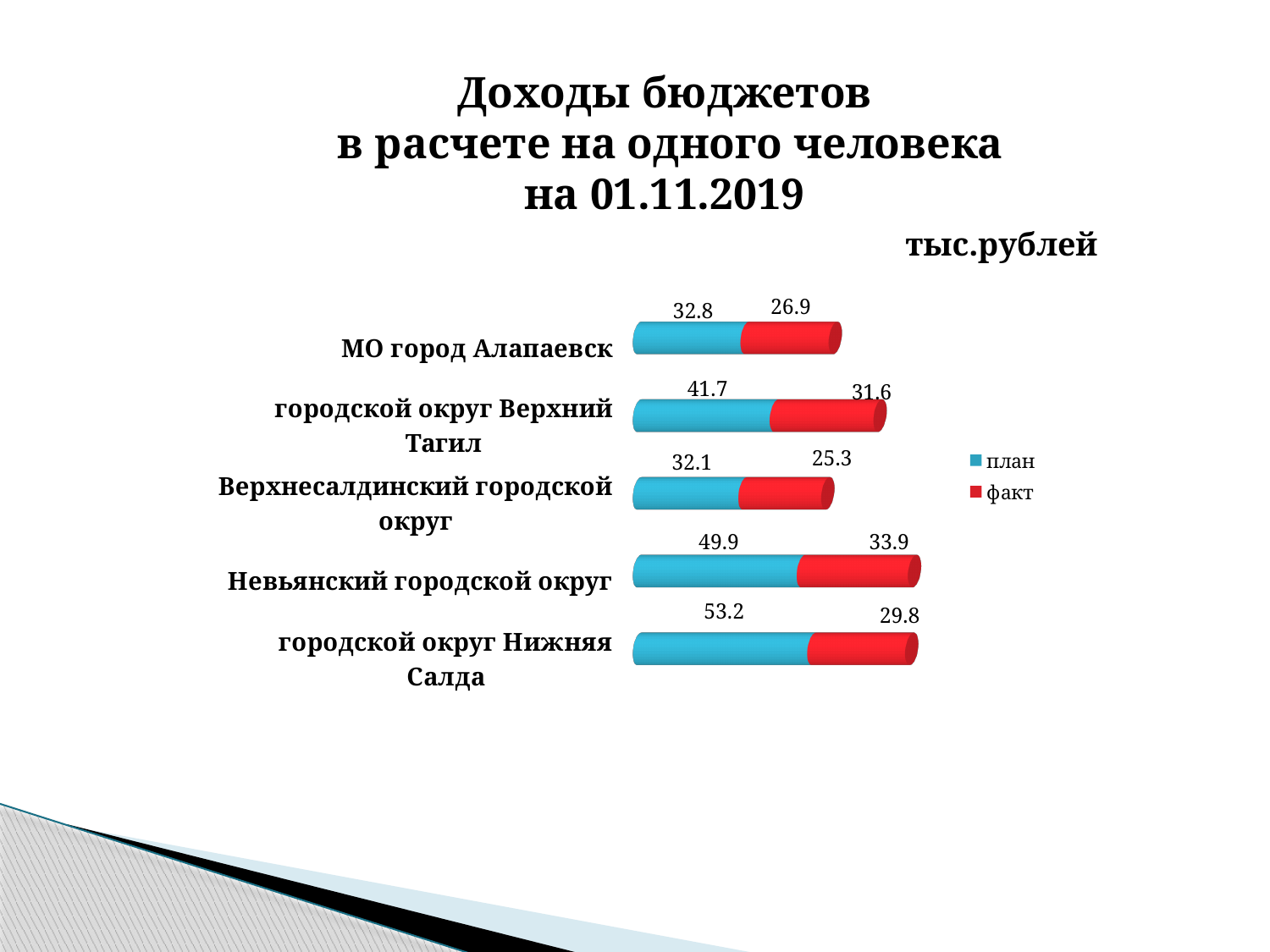
What is the total of the stacked bar for Верхнесалдинский городской округ? 57.4 Which category has the highest план value? городской округ Нижняя Салда What is the факт value for МО город Алапаевск? 26.9 Which category has the lowest факт value? Верхнесалдинский городской округ How many series does the legend list? 2 What unit is stated for the values in the chart? тыс.рублей How many categories are shown in the chart? 5 What is the план value for Невьянский городской округ? 49.9 What kind of chart is shown on the slide? bar chart What is the факт value for городской округ Нижняя Салда? 29.8 What is the difference between the план and факт values for городской округ Верхний Тагил? 10.1 Which is larger: the факт value for Невьянский городской округ or the факт value for городской округ Верхний Тагил? Невьянский городской округ